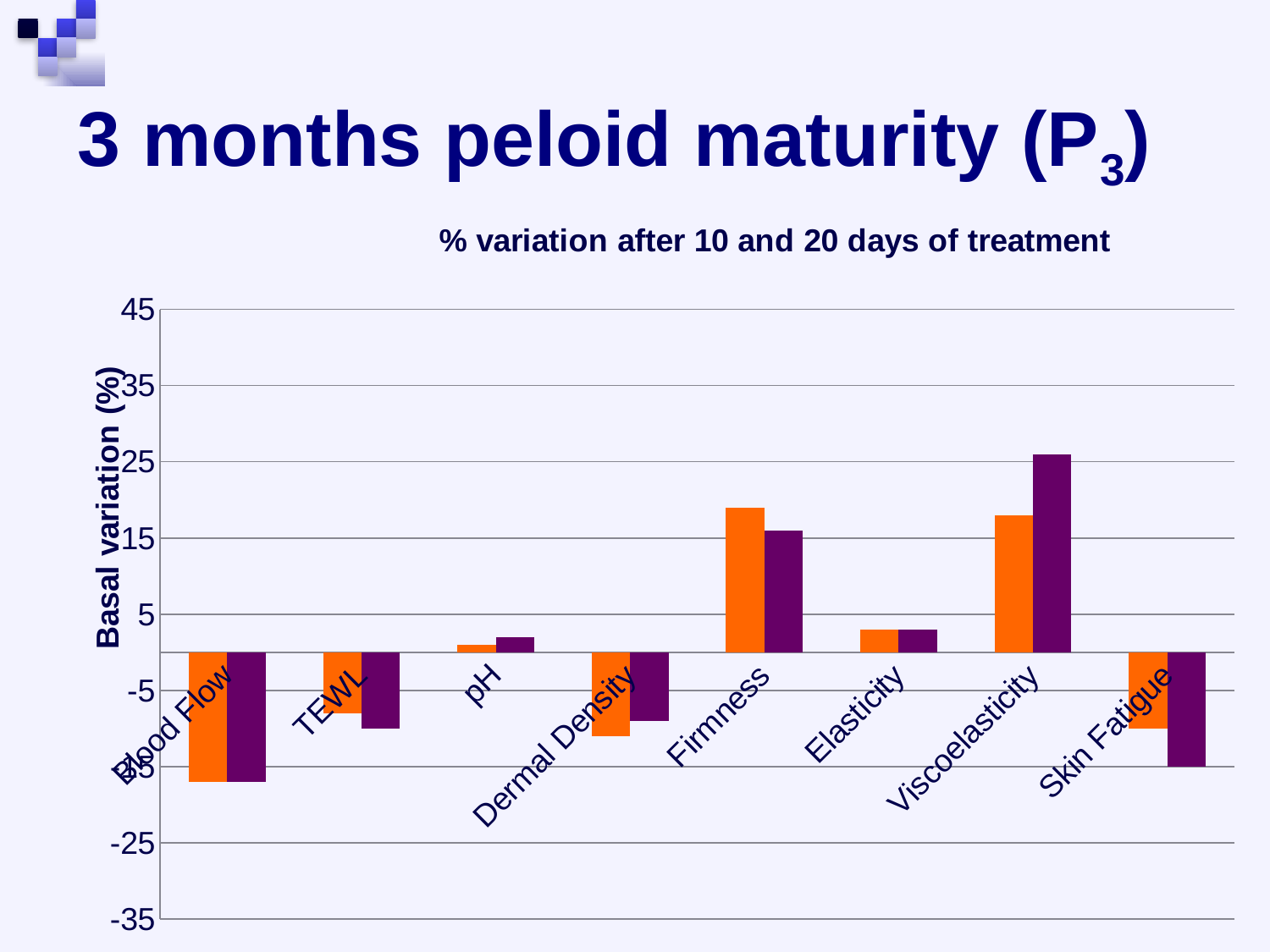
Is the orange bar for Skin Fatigue greater or less than -5? less Is the orange bar for pH greater or less than 5? less For Viscoelasticity, which bar is taller, the orange one or the purple one? Purple What is the label of the vertical axis of the chart? Basal variation (%) For Firmness, which bar is taller, the orange one or the purple one? Orange Which category has the lowest (most negative) bars in the chart? Blood Flow Which category has the tallest bar in the chart? Viscoelasticity Is the orange bar for Blood Flow greater or less than -5? less What kind of chart is shown on the slide? Bar chart How many categories are shown on the x axis of the chart? 8